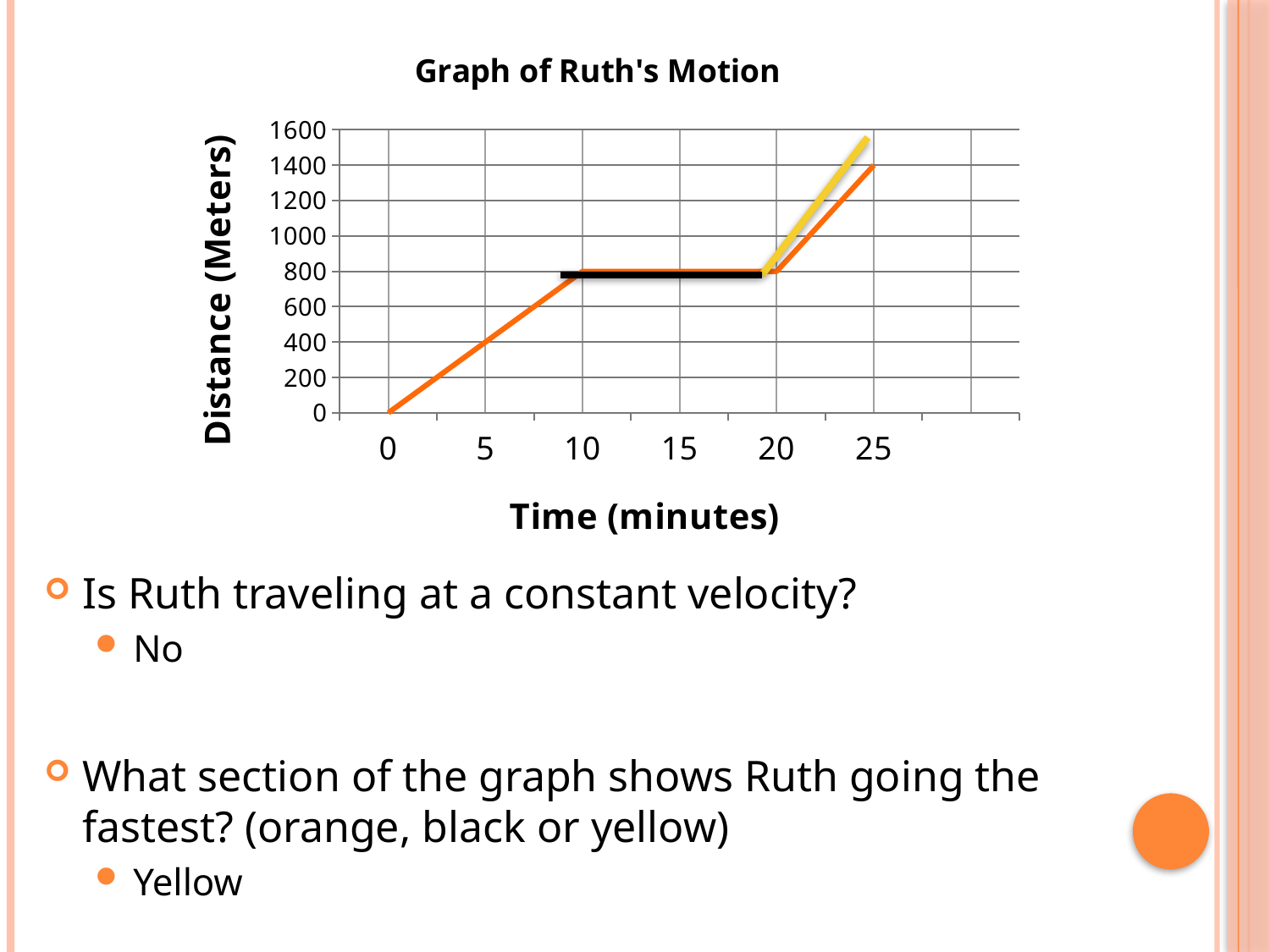
What kind of chart is shown on the slide? line chart What is the title of the chart? Graph of Ruth's Motion What is the label of the vertical axis? Distance (Meters) What distance does the graph show at 15 minutes, during the flat black section? 800 Is the distance on the yellow line at 25 minutes greater or less than 1400? greater Does the distance rise, fall, or stay flat between 10 and 20 minutes? stays flat At 25 minutes, which line shows the larger distance, the yellow line or the orange line? yellow line Is the distance on the orange line at 25 minutes greater or less than 1600? less Is the distance on the orange line at 25 minutes greater or less than 1200? greater What distance does the graph show at time 0 minutes? 0 Overall, does the distance rise or fall as time increases from 0 to 25 minutes? rises